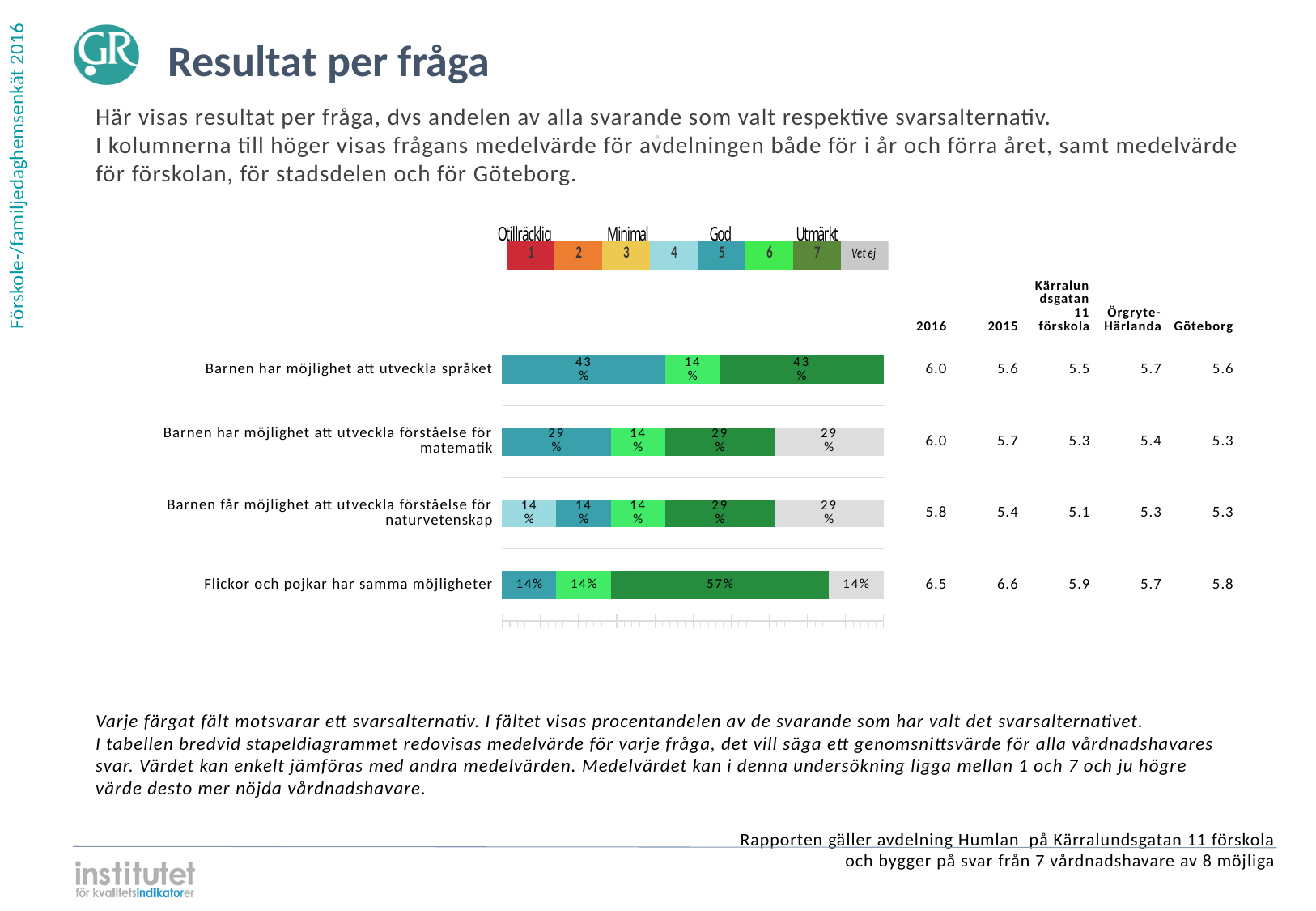
How many answer options, including "Vet ej", does the colour legend above the chart show? 8 What share of respondents answered "Vet ej" for "Barnen har möjlighet att utveckla förståelse för matematik"? 29% What kind of chart is used to show the share of respondents choosing each answer option? Stacked bar chart What percentage chose option 4 (light blue) for "Barnen får möjlighet att utveckla förståelse för naturvetenskap"? 14% What percentage of respondents chose option 5 (teal) for "Barnen har möjlighet att utveckla språket"? 43% What percentage of respondents chose option 7 (dark green) for "Flickor och pojkar har samma möjligheter"? 57% How many questions (bars) are shown in the chart? 4 Which question has the largest single segment in its bar? Flickor och pojkar har samma möjligheter What is the combined share of options 5, 6 and 7 for "Barnen har möjlighet att utveckla språket"? 100% Which is larger: the option 7 share for "Barnen har möjlighet att utveckla språket" or for "Barnen har möjlighet att utveckla förståelse för matematik"? Barnen har möjlighet att utveckla språket What is the 2016 mean value shown for "Flickor och pojkar har samma möjligheter"? 6.5 What is the difference between the option 7 share for "Flickor och pojkar har samma möjligheter" (57%) and for "Barnen har möjlighet att utveckla språket" (43%)? 14%